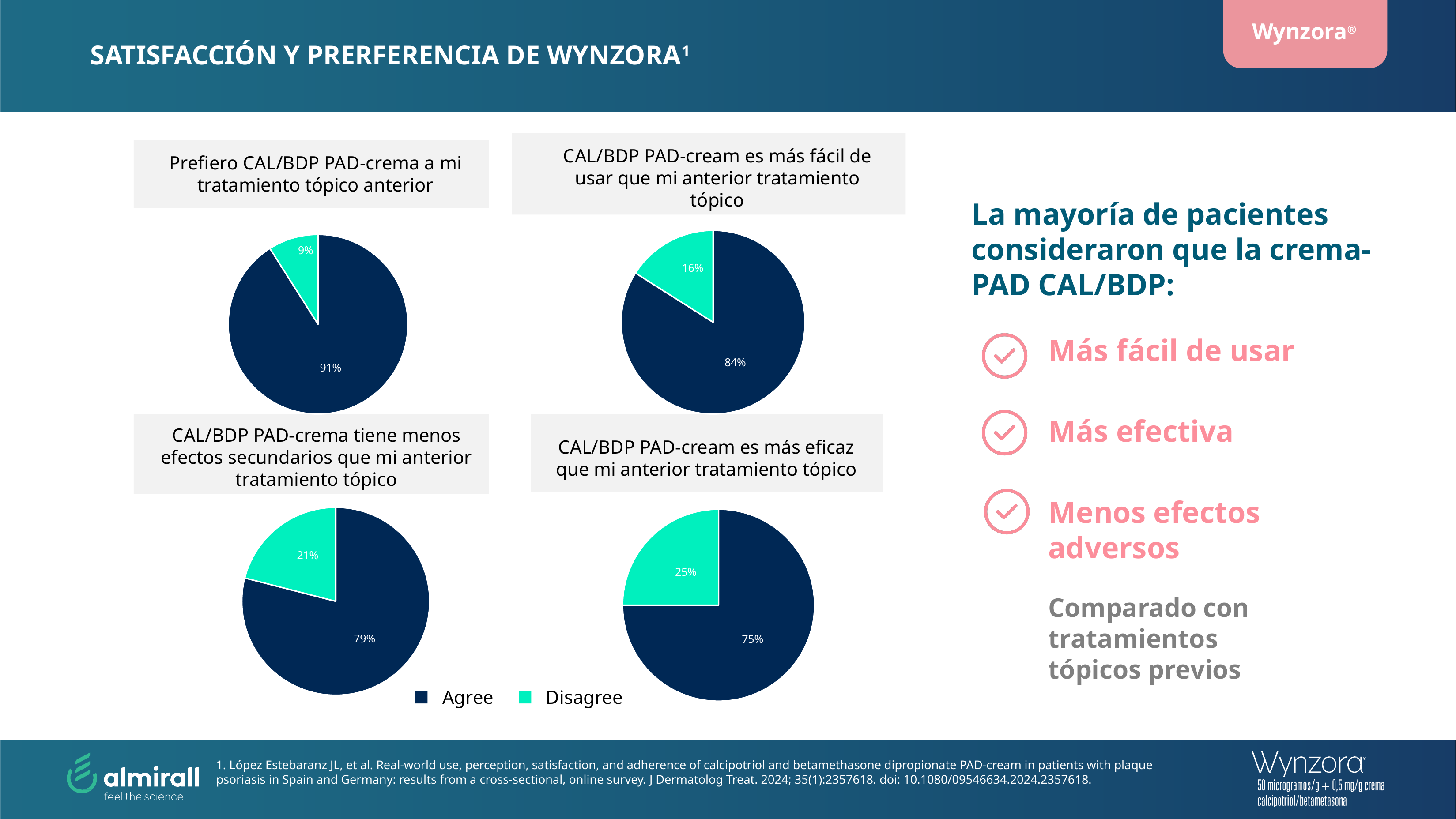
In the pie chart titled 'CAL/BDP PAD-cream es más fácil de usar que mi anterior tratamiento tópico', what percentage is shown for Agree? 84% In the pie chart titled 'CAL/BDP PAD-cream es más eficaz que mi anterior tratamiento tópico', which slice is larger, Agree or Disagree? Agree In the pie chart titled 'CAL/BDP PAD-cream es más fácil de usar que mi anterior tratamiento tópico', what percentage is shown for Disagree? 16% Across the four pie charts, which statement has the lowest Agree percentage? CAL/BDP PAD-cream es más eficaz que mi anterior tratamiento tópico In the pie chart titled 'CAL/BDP PAD-cream es más eficaz que mi anterior tratamiento tópico', what percentage is shown for Disagree? 25% In the pie chart titled 'CAL/BDP PAD-crema tiene menos efectos secundarios que mi anterior tratamiento tópico', what is the difference between the Agree and Disagree percentages? 58% In the pie chart titled 'Prefiero CAL/BDP PAD-crema a mi tratamiento tópico anterior', what percentage is shown for Agree? 91% What type of chart is used to show the survey responses on this slide? Pie chart In the pie chart titled 'Prefiero CAL/BDP PAD-crema a mi tratamiento tópico anterior', what percentage is shown for Disagree? 9% Across the four pie charts, which statement has the highest Agree percentage? Prefiero CAL/BDP PAD-crema a mi tratamiento tópico anterior In the pie chart titled 'CAL/BDP PAD-crema tiene menos efectos secundarios que mi anterior tratamiento tópico', what percentage is shown for Agree? 79% How many entries does the shared legend list for the pie charts? 2